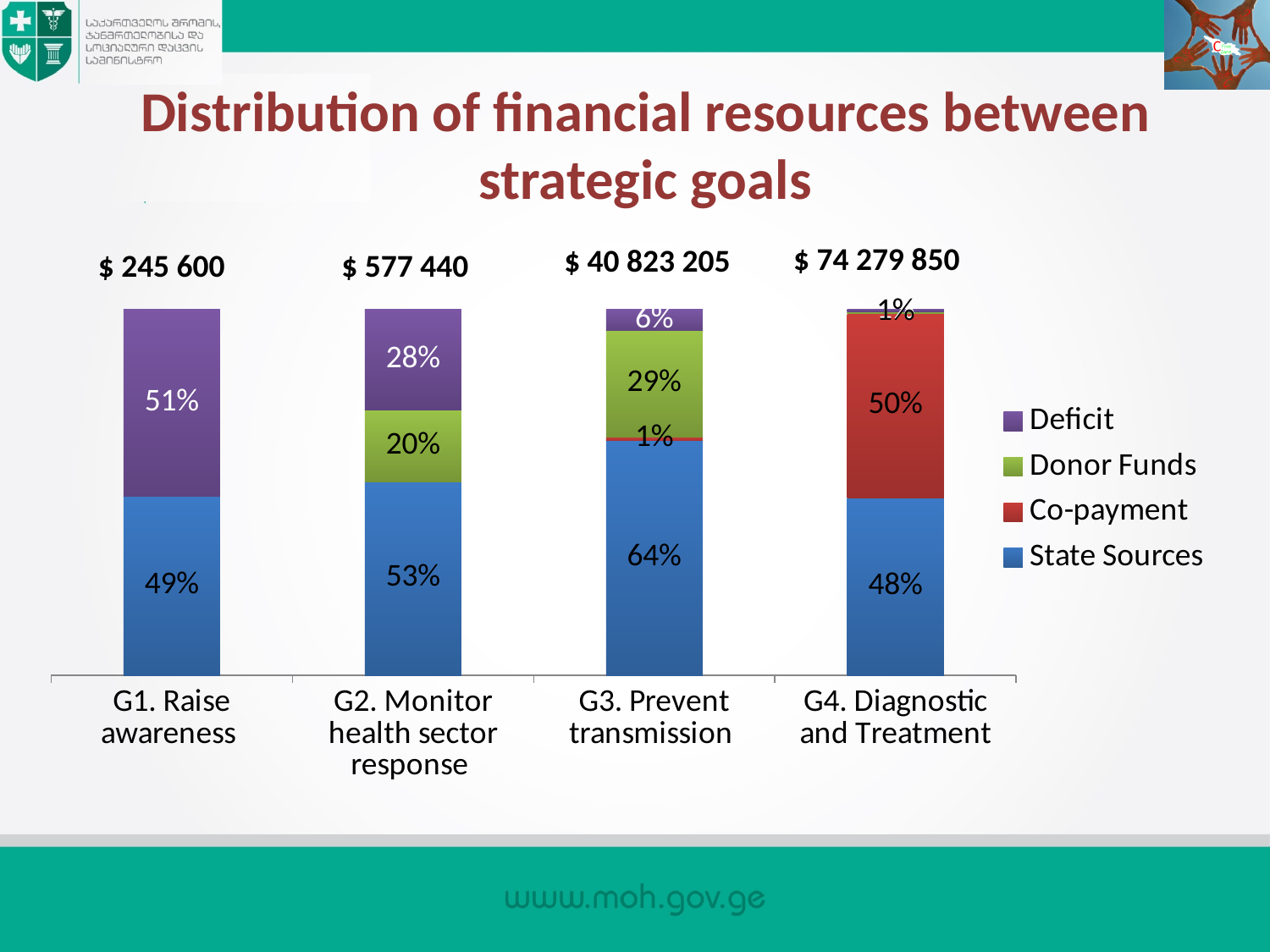
What total amount is shown above the bar for G3. Prevent transmission? $ 40 823 205 Which strategic goal has the highest State Sources share? G3. Prevent transmission What share of G1. Raise awareness comes from State Sources? 49% What is the Deficit share for G2. Monitor health sector response? 28% Which is larger: the Donor Funds share for G2. Monitor health sector response or for G3. Prevent transmission? G3. Prevent transmission What type of chart is shown on the slide? stacked bar chart How many series does the legend list? 4 What is the Donor Funds share for G3. Prevent transmission? 29% How many strategic goals (categories) are shown on the x axis? 4 What is the Co-payment share for G4. Diagnostic and Treatment? 50% Which strategic goal has the lowest State Sources share? G4. Diagnostic and Treatment What is the difference between the Deficit share of G1. Raise awareness and that of G2. Monitor health sector response? 23%